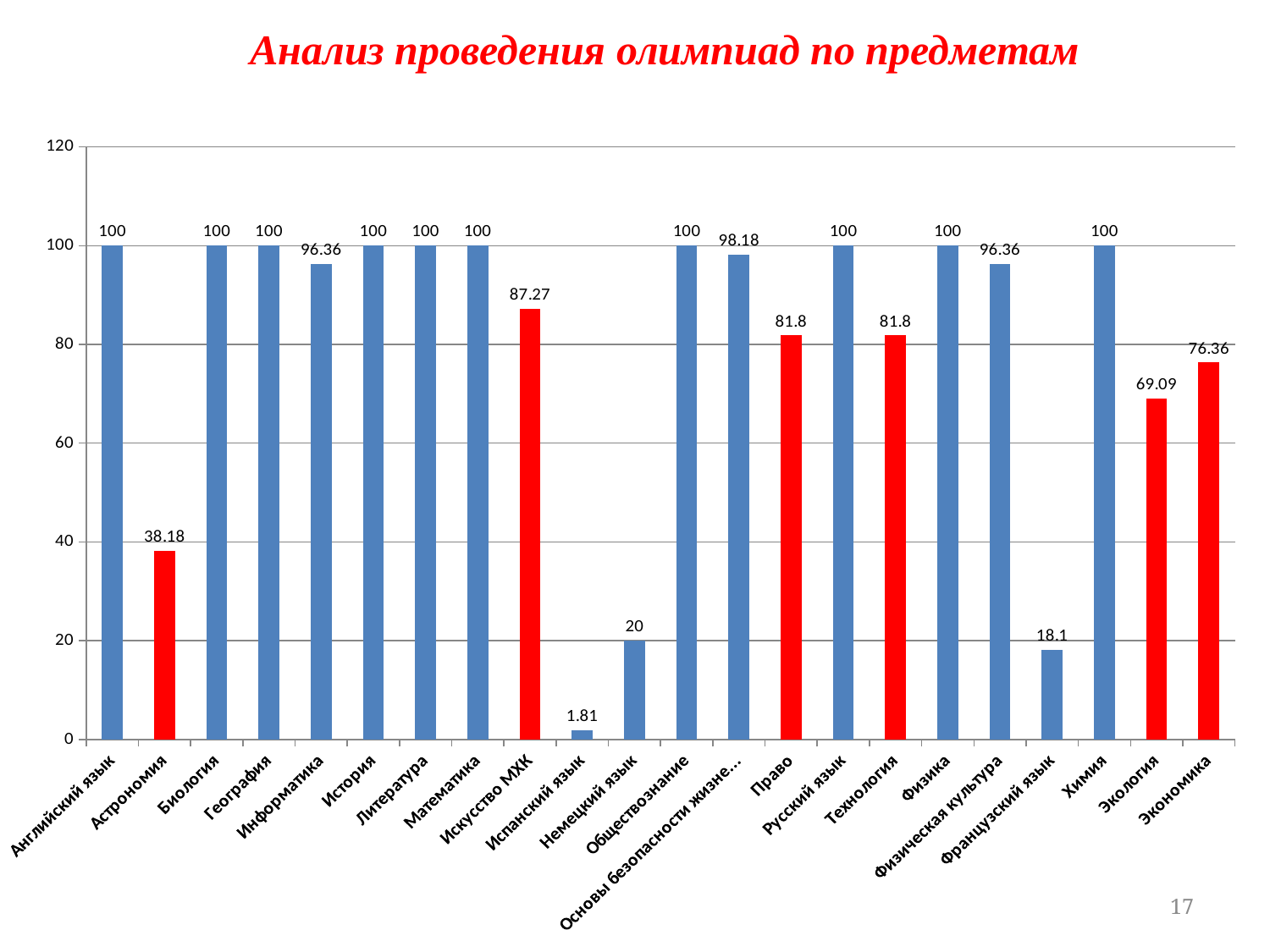
What is the value for Искусство МХК? 87.27 What is the value for Испанский язык? 1.81 How many subjects are shown on the x axis? 22 What is the value for Астрономия? 38.18 What is the difference between the values for Экономика and Экология? 7.27 Which subject has the lowest value? Испанский язык What is the title of the chart? Анализ проведения олимпиад по предметам Which is larger, the value for Право or the value for Экономика? Право What is the value for Экология? 69.09 What is the difference between the values for Немецкий язык and Французский язык? 1.9 What kind of chart is shown on the slide? Bar chart Is the value for Физическая культура greater or less than 80? greater